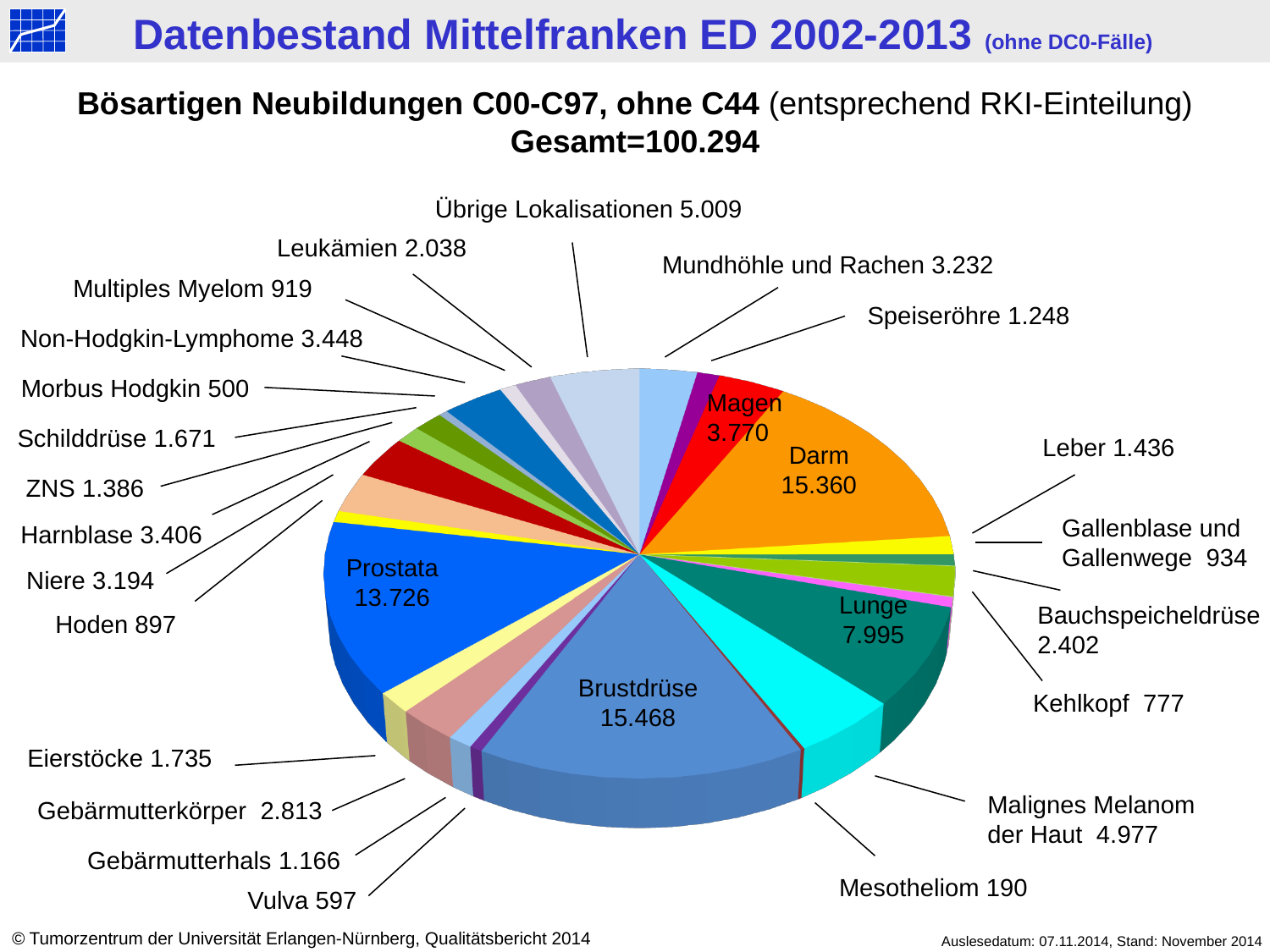
Which category has the smallest slice of the pie? Mesotheliom What is the difference between the values for Darm and Prostata? 1.634 What is the value shown for Malignes Melanom der Haut? 4.977 What is the value shown for Gebärmutterkörper? 2.813 What is the value shown for Darm? 15.360 How many slices does the pie chart have? 27 What is the difference between the values for Lunge and Malignes Melanom der Haut? 3.018 What kind of chart is shown on the slide? Pie chart Which is larger, the value for Harnblase or the value for Niere? Harnblase What is the value shown for Lunge? 7.995 What total (Gesamt) is stated for the pie chart? 100.294 Which category has the largest slice of the pie? Brustdrüse